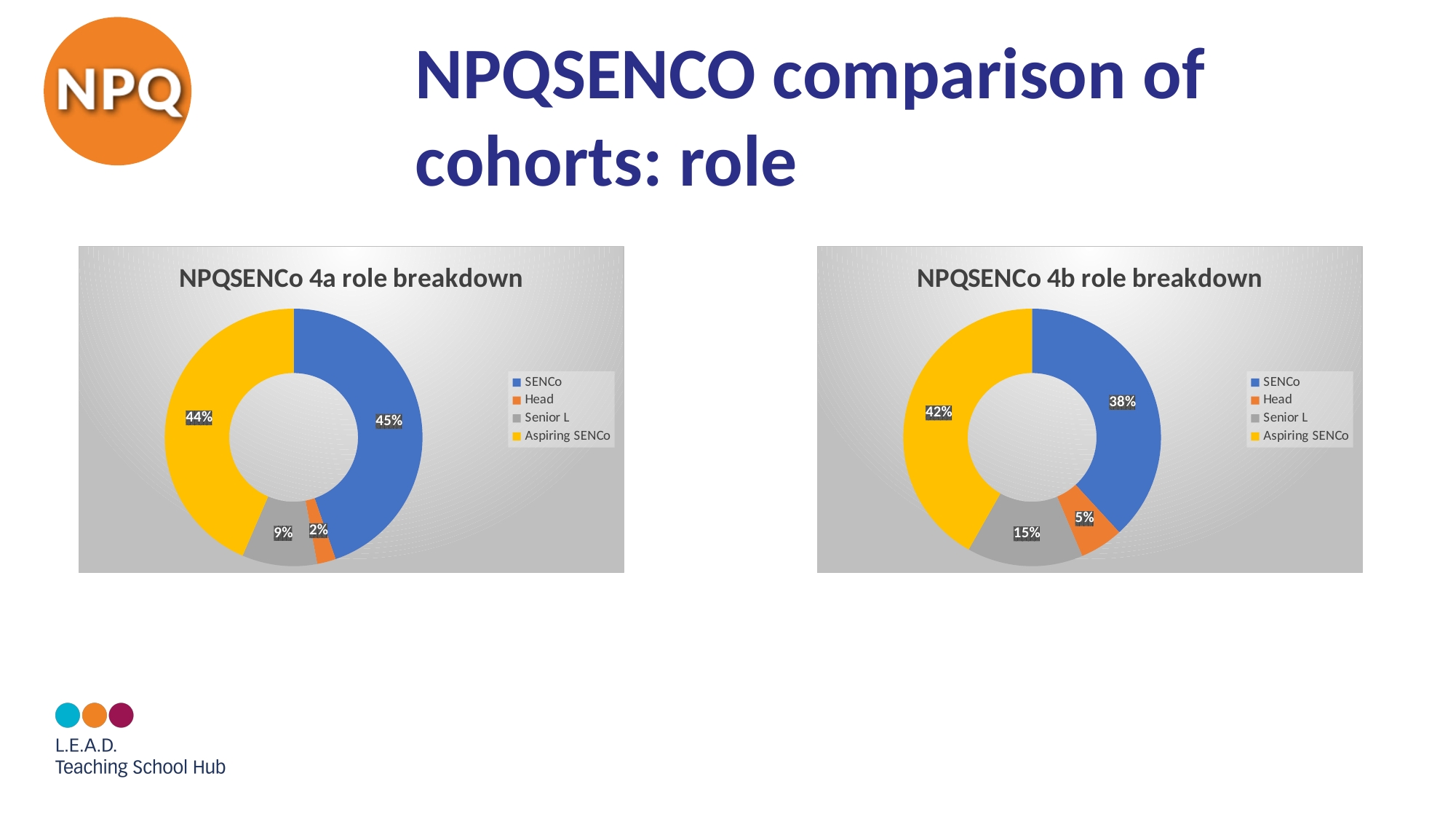
In the NPQSENCo 4a role breakdown chart, which colour represents Aspiring SENCo? Yellow In the NPQSENCo 4a role breakdown chart, what percentage is SENCo? 45% In the NPQSENCo 4a role breakdown chart, what is the difference between the Aspiring SENCo and Senior L shares? 35% How many roles are shown in the NPQSENCo 4a role breakdown chart? 4 In the NPQSENCo 4b role breakdown chart, what is the difference between the SENCo and Head shares? 33% In the NPQSENCo 4b role breakdown chart, what percentage is Aspiring SENCo? 42% What type of chart is the NPQSENCo 4b role breakdown? Doughnut (pie) chart Which chart shows a larger share for Senior L, NPQSENCo 4a or NPQSENCo 4b? NPQSENCo 4b In the NPQSENCo 4a role breakdown chart, what percentage is Head? 2% In the NPQSENCo 4b role breakdown chart, which role has the largest share? Aspiring SENCo In the NPQSENCo 4b role breakdown chart, what percentage is Senior L? 15% In the NPQSENCo 4a role breakdown chart, which role has the smallest share? Head